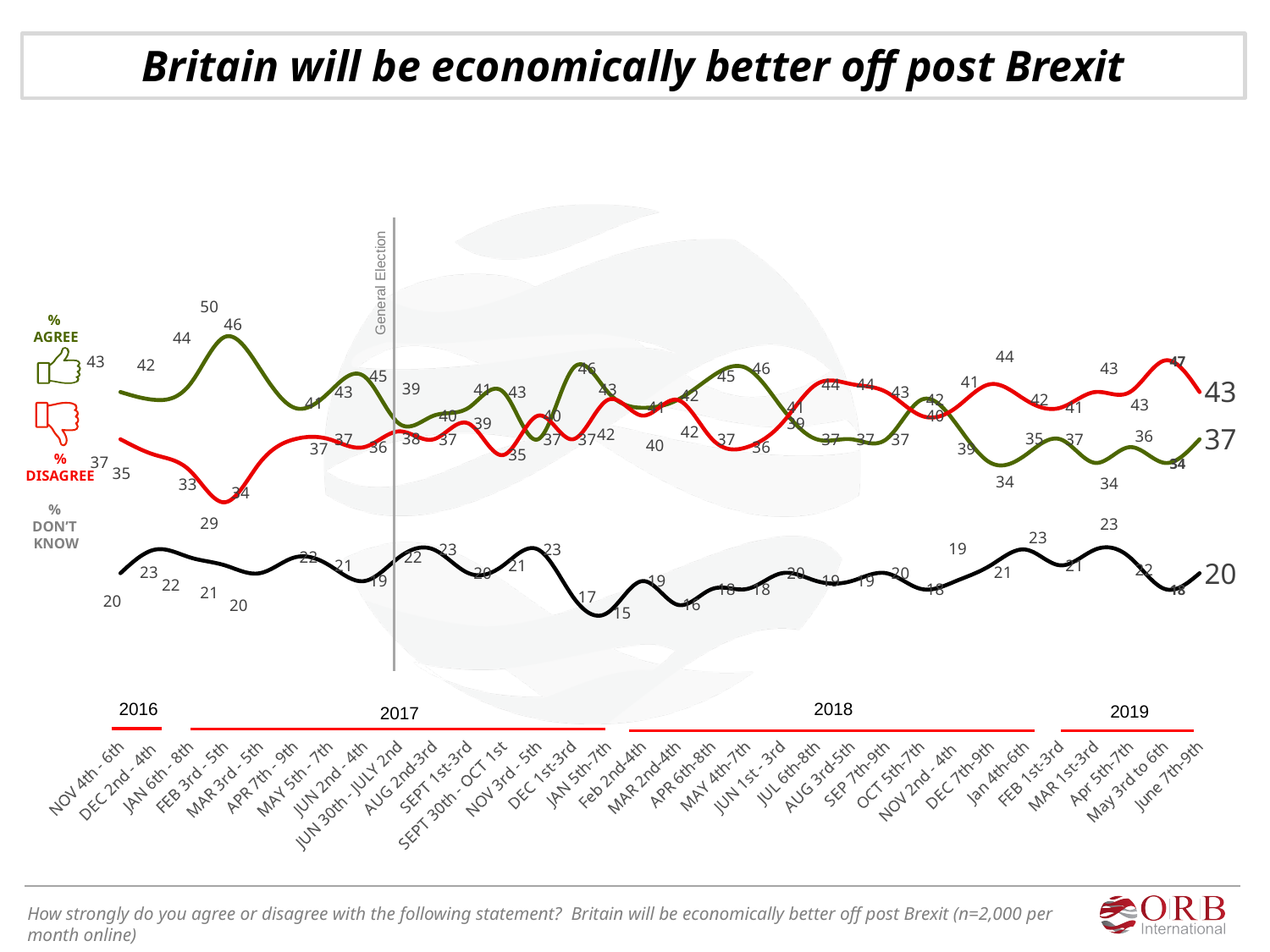
What is the lowest value reached by the % Don't Know line? 15 What kind of chart is shown on the slide? line chart What is the lowest value reached by the % Disagree line? 29 What is the % Don't Know value at the final point, June 7th-9th 2019? 20 What is the highest value reached by the % Agree line? 50 What event does the vertical grey line on the chart mark? General Election At June 7th-9th 2019, how much higher is % Disagree than % Agree? 6 How many series does the chart show? 3 What is the % Disagree value at the final point, June 7th-9th 2019? 43 At the first point, Nov 4th-6th 2016, which is larger: % Agree or % Disagree? % Agree How many survey dates are plotted along the x axis? 32 What is the % Agree value at the final point, June 7th-9th 2019? 37